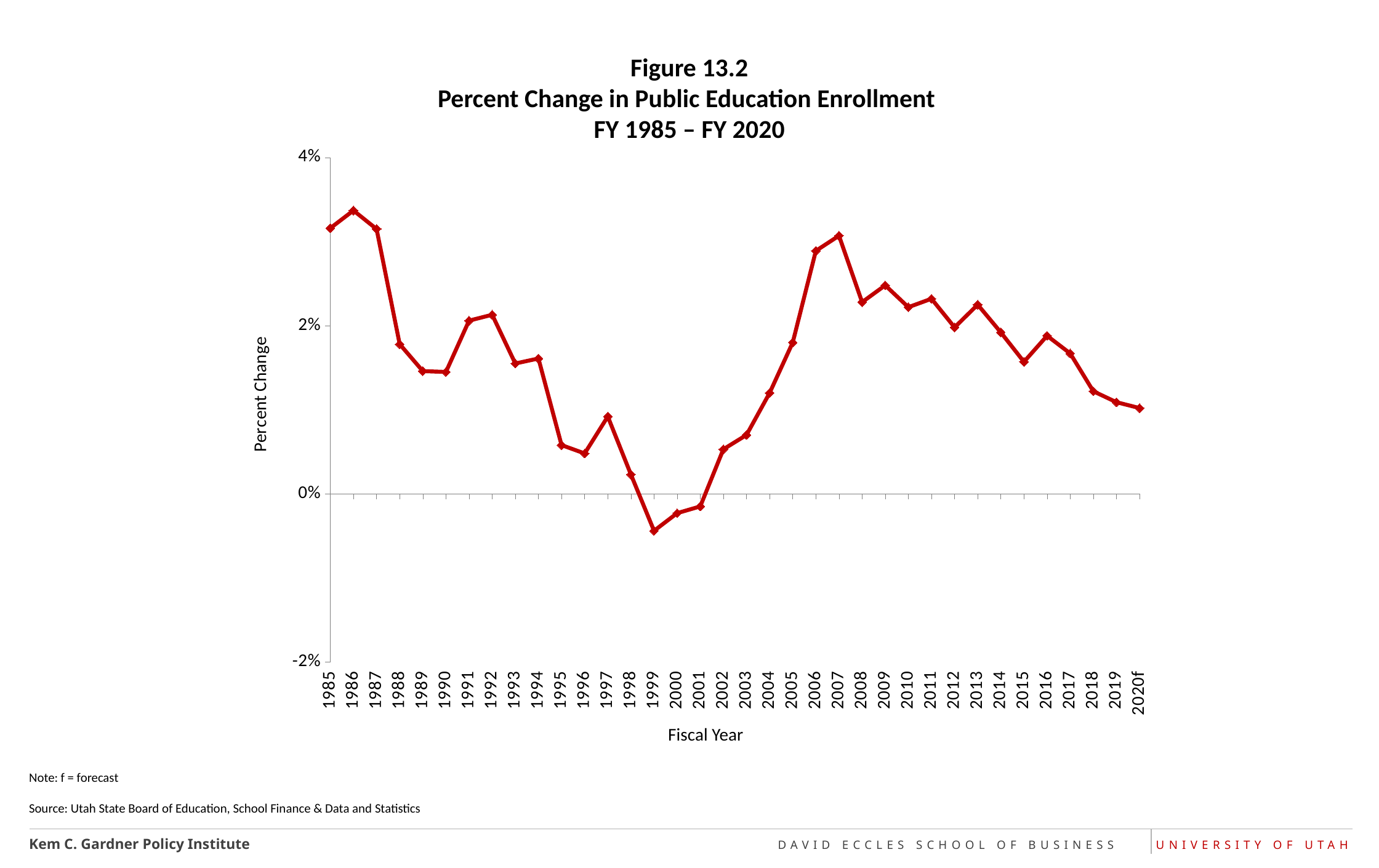
Which fiscal year has the highest percent change in public education enrollment? 1986 Which fiscal year has the larger percent change, 1986 or 2007? 1986 Is the percent change for 1999 greater or less than 0%? less Which fiscal year has the larger percent change, 1992 or 1993? 1992 How many fiscal years are plotted on the chart? 36 Is the percent change for 1985 greater or less than 2%? greater Which fiscal year has the lowest percent change in public education enrollment? 1999 Is the percent change for 2020f greater or less than 2%? less Do the values generally rise or fall from 2007 to 2020f? fall How many fiscal years show a percent change below 0%? 3 What kind of chart is shown on the slide? Line chart